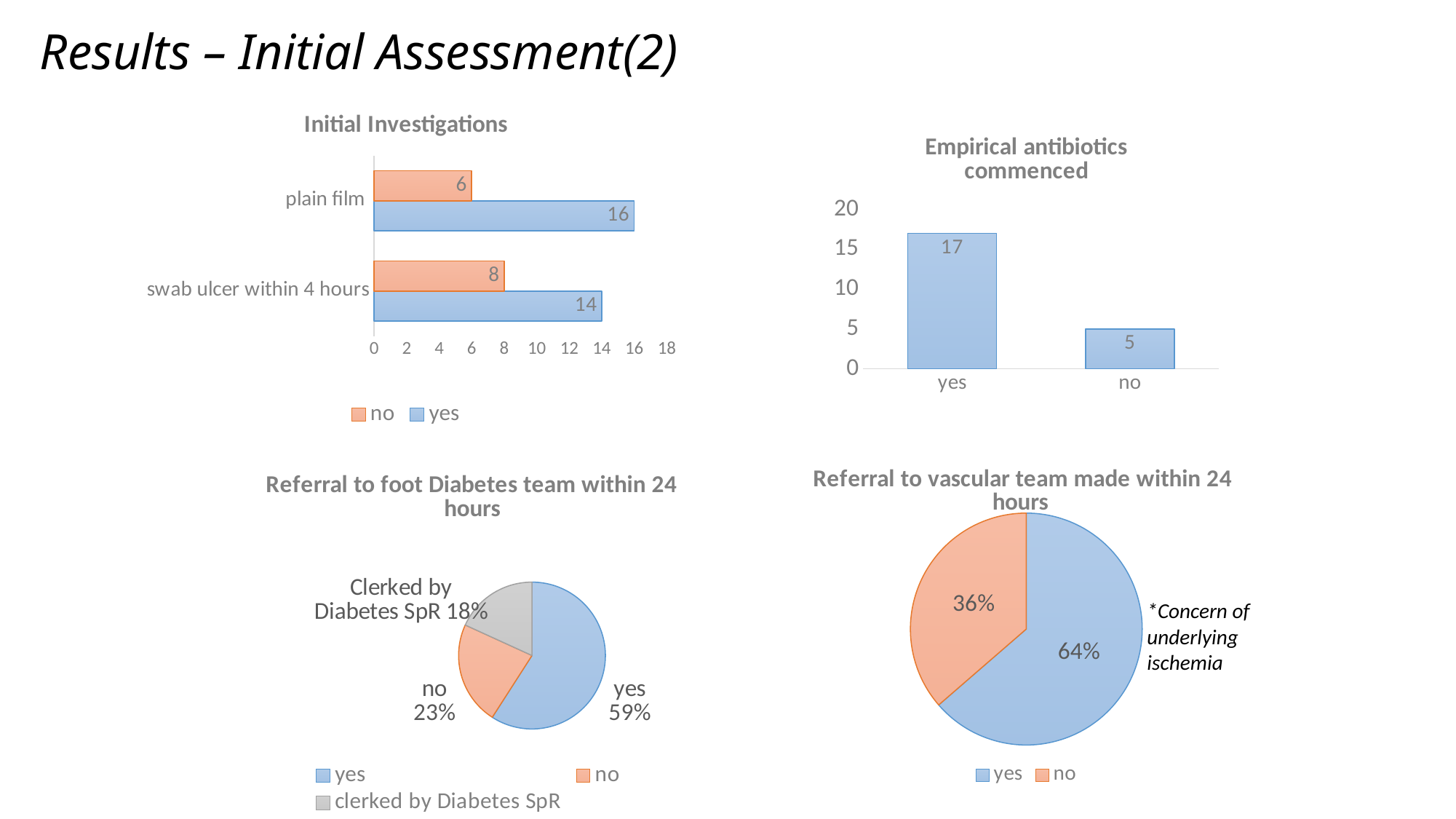
In the 'Referral to foot Diabetes team within 24 hours' pie chart, how many slices are there? 3 In the 'Initial Investigations' chart, what is the difference between the 'yes' and 'no' values for plain film? 10 In the 'Referral to foot Diabetes team within 24 hours' pie chart, what share is 'no'? 23% In the 'Initial Investigations' chart, how many series does the legend list? 2 In the 'Referral to vascular team made within 24 hours' pie chart, what share is 'yes'? 64% In the 'Initial Investigations' chart, what is the value for 'yes' for plain film? 16 In the 'Empirical antibiotics commenced' chart, what is the value for 'yes'? 17 In the 'Empirical antibiotics commenced' chart, what is the difference between 'yes' and 'no'? 12 In the 'Initial Investigations' chart, what is the value for 'no' for swab ulcer within 4 hours? 8 In the 'Empirical antibiotics commenced' chart, which category has the lowest value? no What kind of chart is the 'Initial Investigations' chart? bar chart In the 'Referral to vascular team made within 24 hours' pie chart, which slice is larger, 'yes' or 'no'? yes